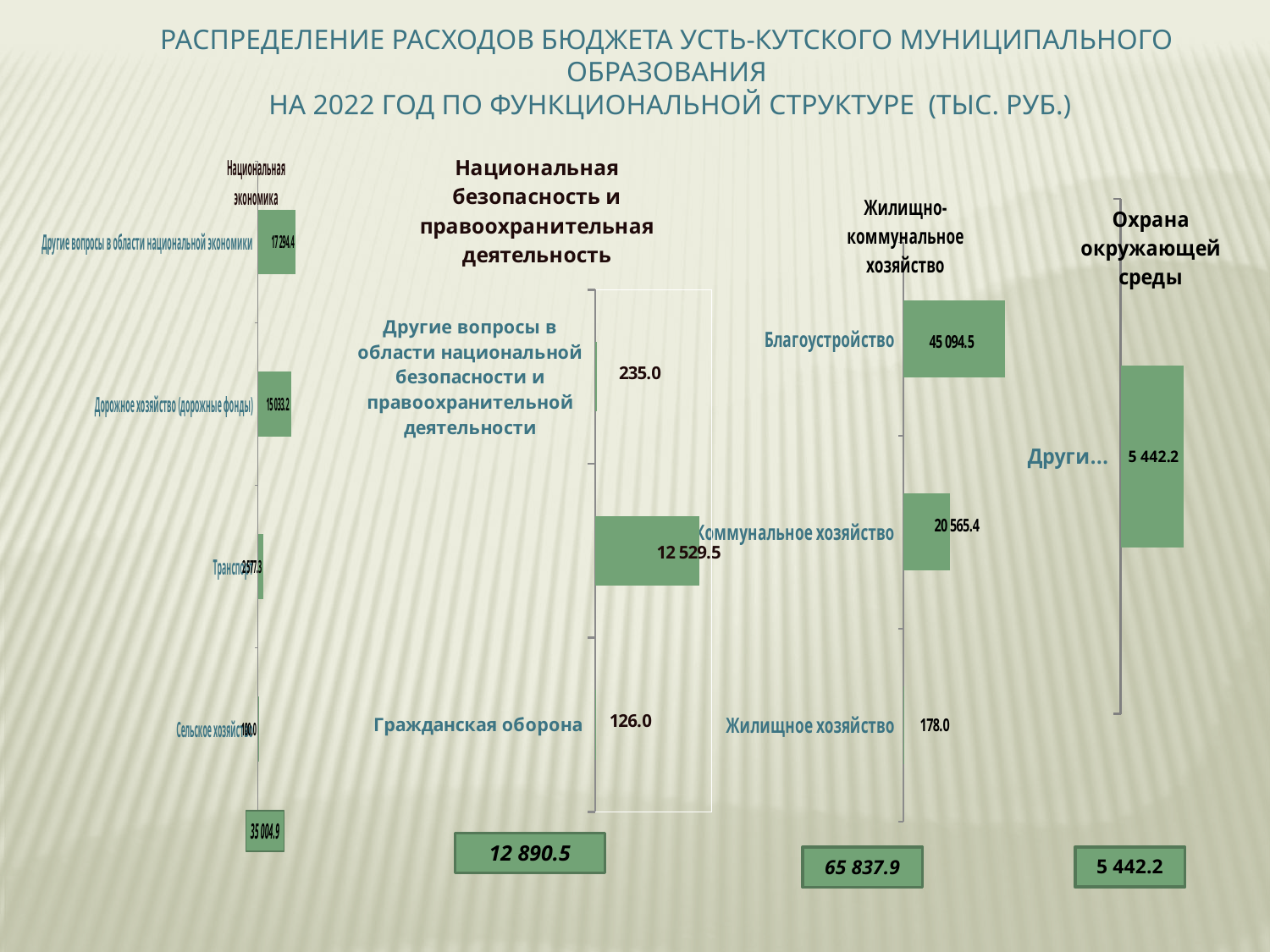
In the 'Национальная экономика' chart, which is larger: 'Другие вопросы в области национальной экономики' or 'Дорожное хозяйство (дорожные фонды)'? Другие вопросы в области национальной экономики What total is shown below the 'Жилищно-коммунальное хозяйство' chart? 65 837.9 In the 'Национальная безопасность и правоохранительная деятельность' chart, what is the value for 'Другие вопросы в области национальной безопасности и правоохранительной деятельности'? 235.0 In the 'Национальная безопасность и правоохранительная деятельность' chart, what is the value for Гражданская оборона? 126.0 In the 'Национальная экономика' chart, what is the value for 'Другие вопросы в области национальной экономики'? 17 294.4 In the 'Жилищно-коммунальное хозяйство' chart, which category has the lowest value? Жилищное хозяйство In the 'Жилищно-коммунальное хозяйство' chart, what is the value for Жилищное хозяйство? 178.0 In the 'Жилищно-коммунальное хозяйство' chart, what is the value for Коммунальное хозяйство? 20 565.4 In the 'Жилищно-коммунальное хозяйство' chart, which category has the highest value? Благоустройство In the 'Жилищно-коммунальное хозяйство' chart, what is the value for Благоустройство? 45 094.5 What kind of chart is the 'Охрана окружающей среды' chart? bar chart In the 'Жилищно-коммунальное хозяйство' chart, what is the difference between Благоустройство and Коммунальное хозяйство? 24 529.1